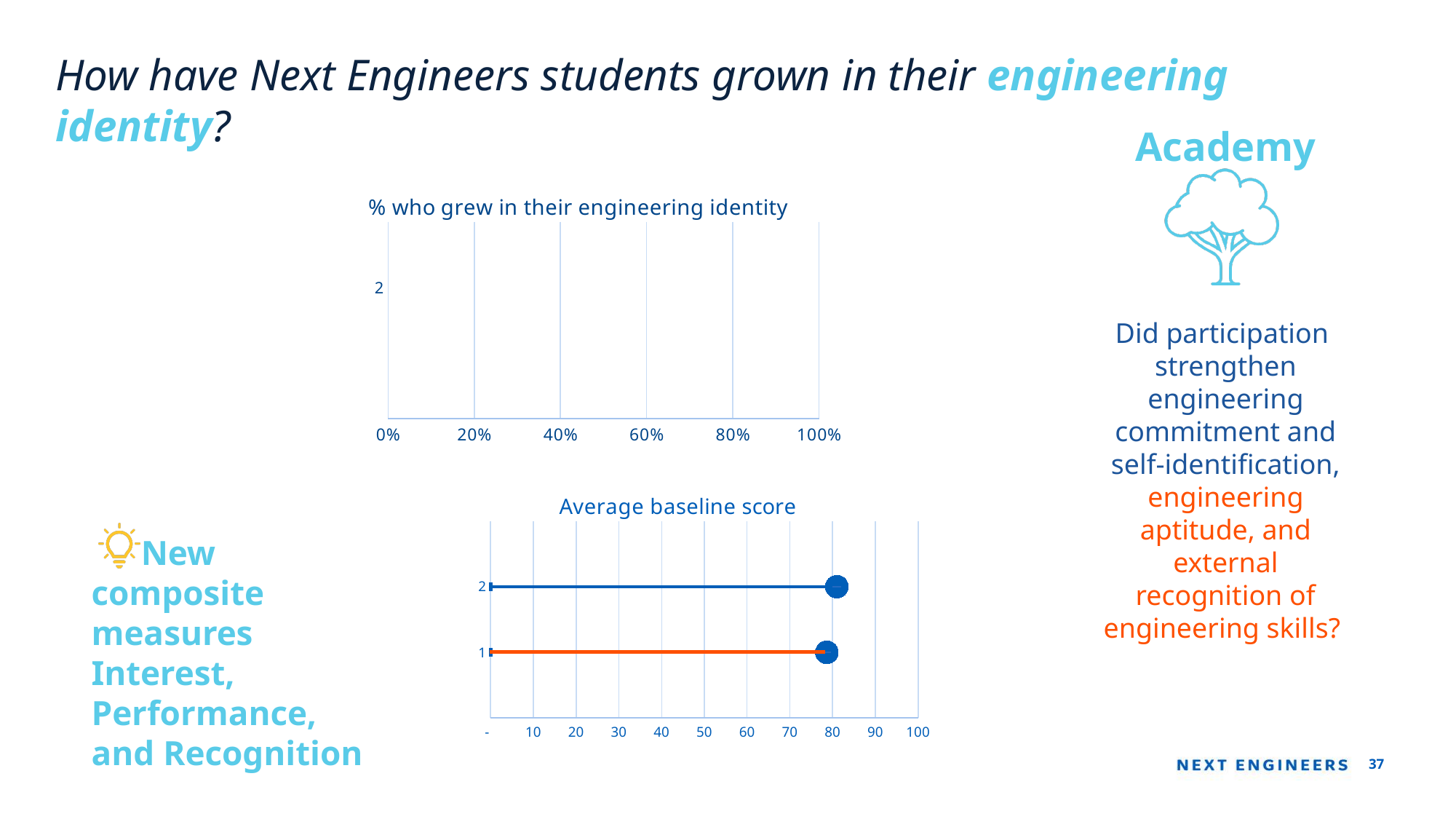
What is the title of the top chart on the slide? % who grew in their engineering identity In the 'Average baseline score' chart, is the value for category 1 greater or less than 60? greater How many categories are plotted in the 'Average baseline score' chart? 2 What kind of chart is the 'Average baseline score' chart? bar chart In the 'Average baseline score' chart, is the value for category 2 greater or less than 70? greater What is the highest tick value shown on the x axis of the 'Average baseline score' chart? 100 In the 'Average baseline score' chart, is the value for category 1 greater or less than 90? less